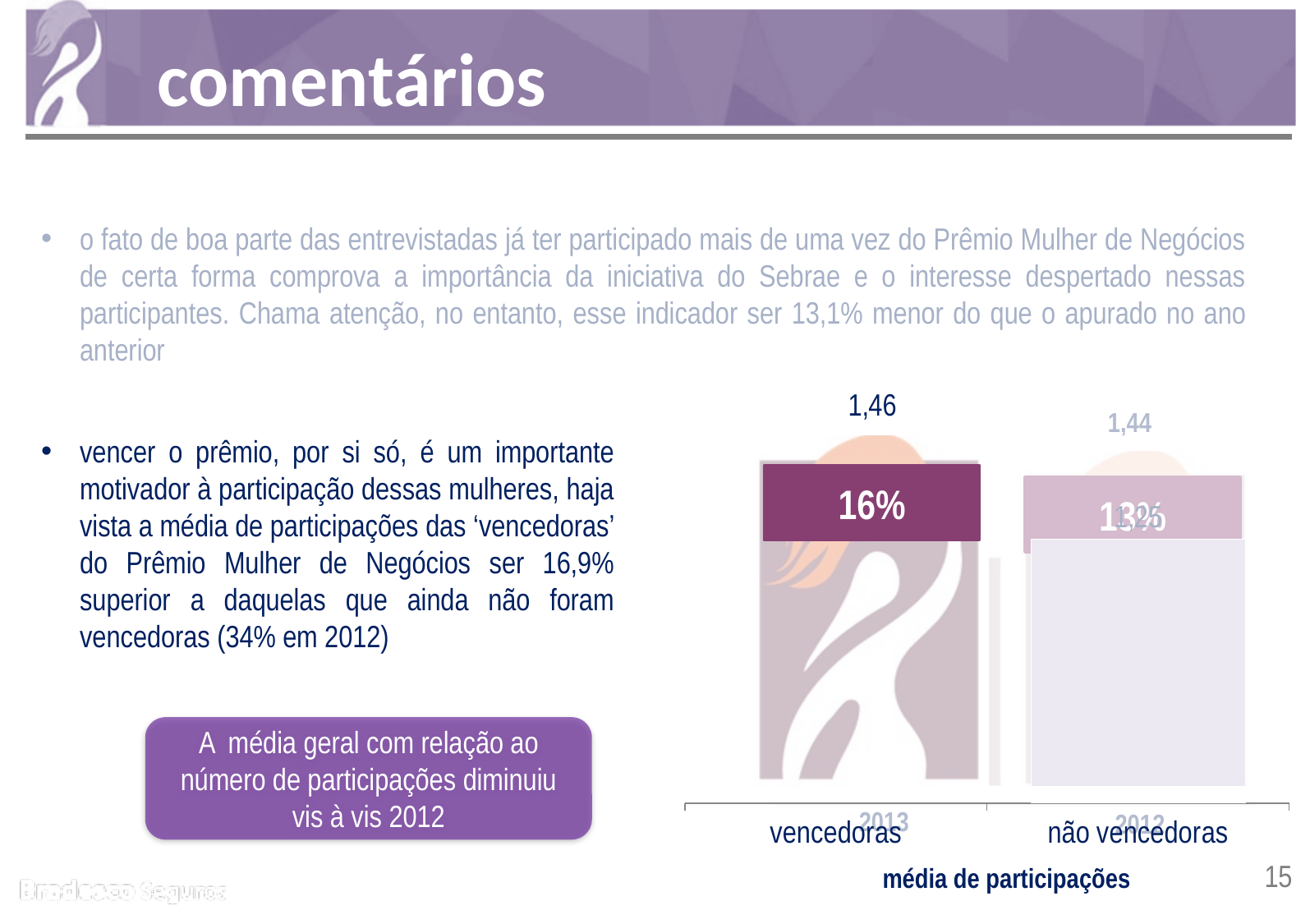
What are the two category labels on the x axis of the 'média de participações' chart? vencedoras, não vencedoras What kind of chart is the 'média de participações' chart? bar chart Which category has the highest value in the 'média de participações' chart? vencedoras In the 'média de participações' chart, which is larger: the value for 'vencedoras' or for 'não vencedoras'? vencedoras What is the title of the chart on the right side of the slide? média de participações Which category has the lowest value in the 'média de participações' chart? não vencedoras How many categories are shown in the 'média de participações' chart? 2